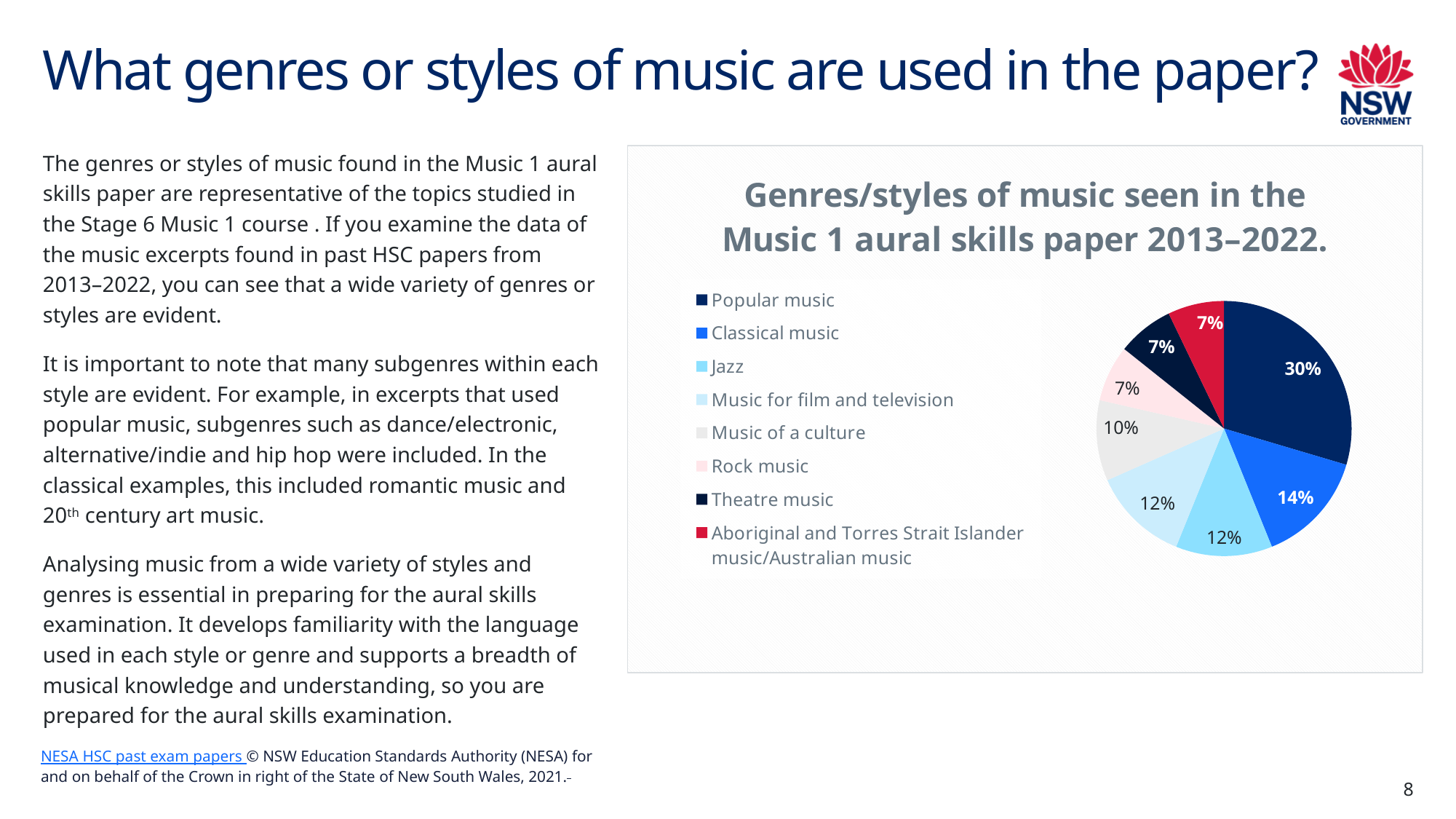
Which is larger, the share for Classical music or the share for Music of a culture? Classical music How many genres/styles does the legend list? 8 What share of the pie is Jazz? 12% What share of the pie is Rock music? 7% What type of chart is shown on the slide? pie chart What colour is the slice for Aboriginal and Torres Strait Islander music/Australian music? red What share of the pie is Music of a culture? 10% Which genre/style has the largest slice of the pie? Popular music What is the title of the chart? Genres/styles of music seen in the Music 1 aural skills paper 2013–2022. What is the difference between the share for Popular music and the share for Classical music? 16%